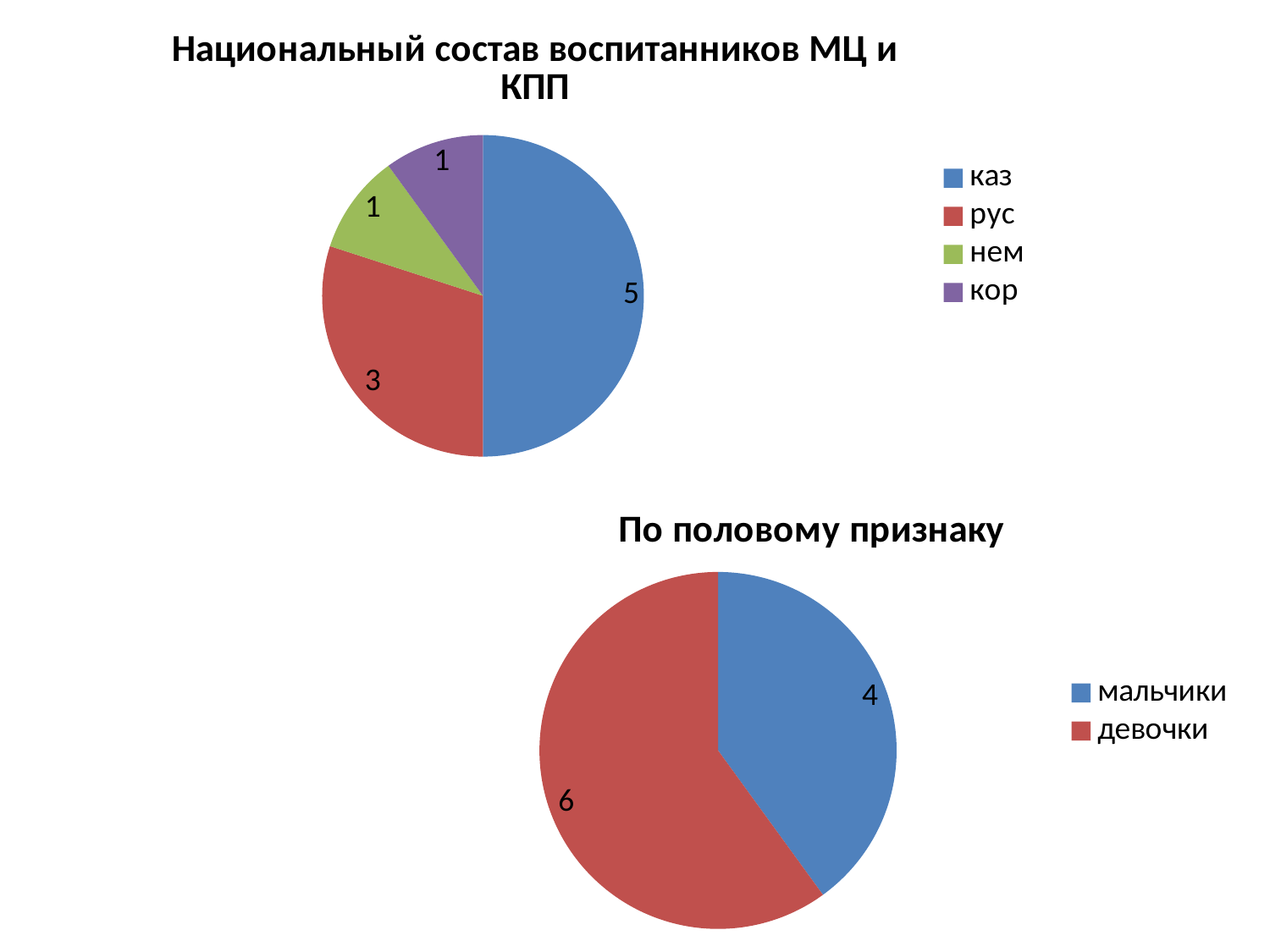
In the chart titled 'По половому признаку', what is the value for девочки? 6 In the chart titled 'По половому признаку', what share of the total do девочки represent? 60% In the chart titled 'Национальный состав воспитанников МЦ и КПП', what is the difference between the values for каз and рус? 2 What kind of chart is the chart titled 'Национальный состав воспитанников МЦ и КПП'? pie chart In the chart titled 'По половому признаку', what is the value for мальчики? 4 In the chart titled 'Национальный состав воспитанников МЦ и КПП', what share of the total does каз represent? 50% In the chart titled 'Национальный состав воспитанников МЦ и КПП', how many categories does the legend list? 4 In the chart titled 'По половому признаку', which is larger, мальчики or девочки? девочки In the chart titled 'По половому признаку', what colour is the slice for мальчики? blue In the chart titled 'Национальный состав воспитанников МЦ и КПП', which category has the largest slice? каз In the chart titled 'Национальный состав воспитанников МЦ и КПП', what is the value for рус? 3 In the chart titled 'Национальный состав воспитанников МЦ и КПП', what is the value for каз? 5